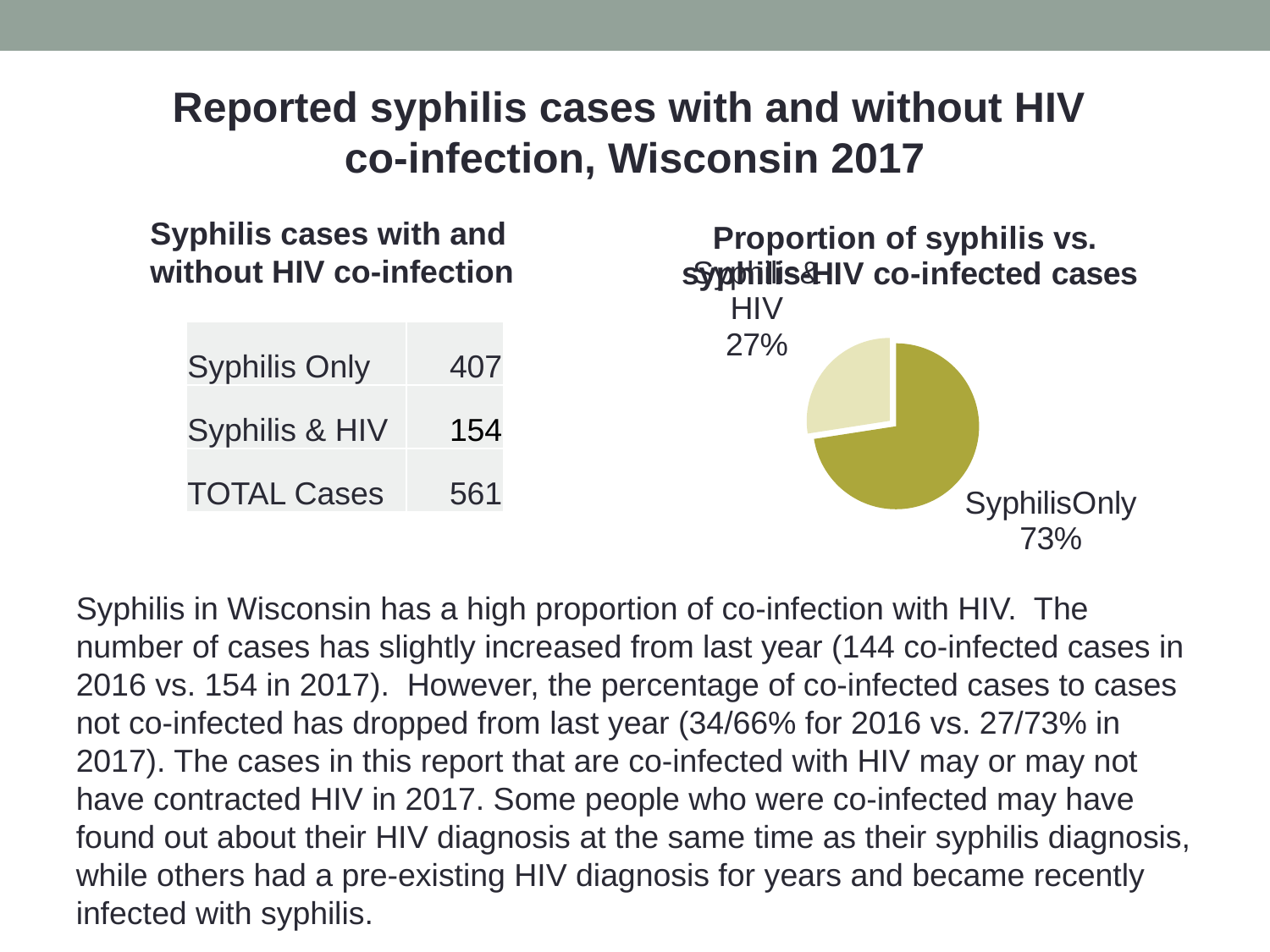
What is the difference in percentage points between the Syphilis Only slice and the Syphilis & HIV slice in the pie chart? 46 How many slices does the pie chart have? 2 What share of the pie chart does the Syphilis & HIV slice represent? 27% What kind of chart is shown on the slide? Pie chart Which slice of the pie chart is the largest? Syphilis Only Which slice of the pie chart is shown in the darker olive colour? Syphilis Only In the pie chart, which is larger: the Syphilis Only slice or the Syphilis & HIV slice? Syphilis Only What is the title of the pie chart? Proportion of syphilis vs. syphilis-HIV co-infected cases Which slice of the pie chart is the smallest? Syphilis & HIV In the pie chart, what percentage is shown for Syphilis Only? 73% In the pie chart, what percentage is shown for Syphilis & HIV? 27% Is the Syphilis Only slice of the pie chart greater or less than 50%? greater